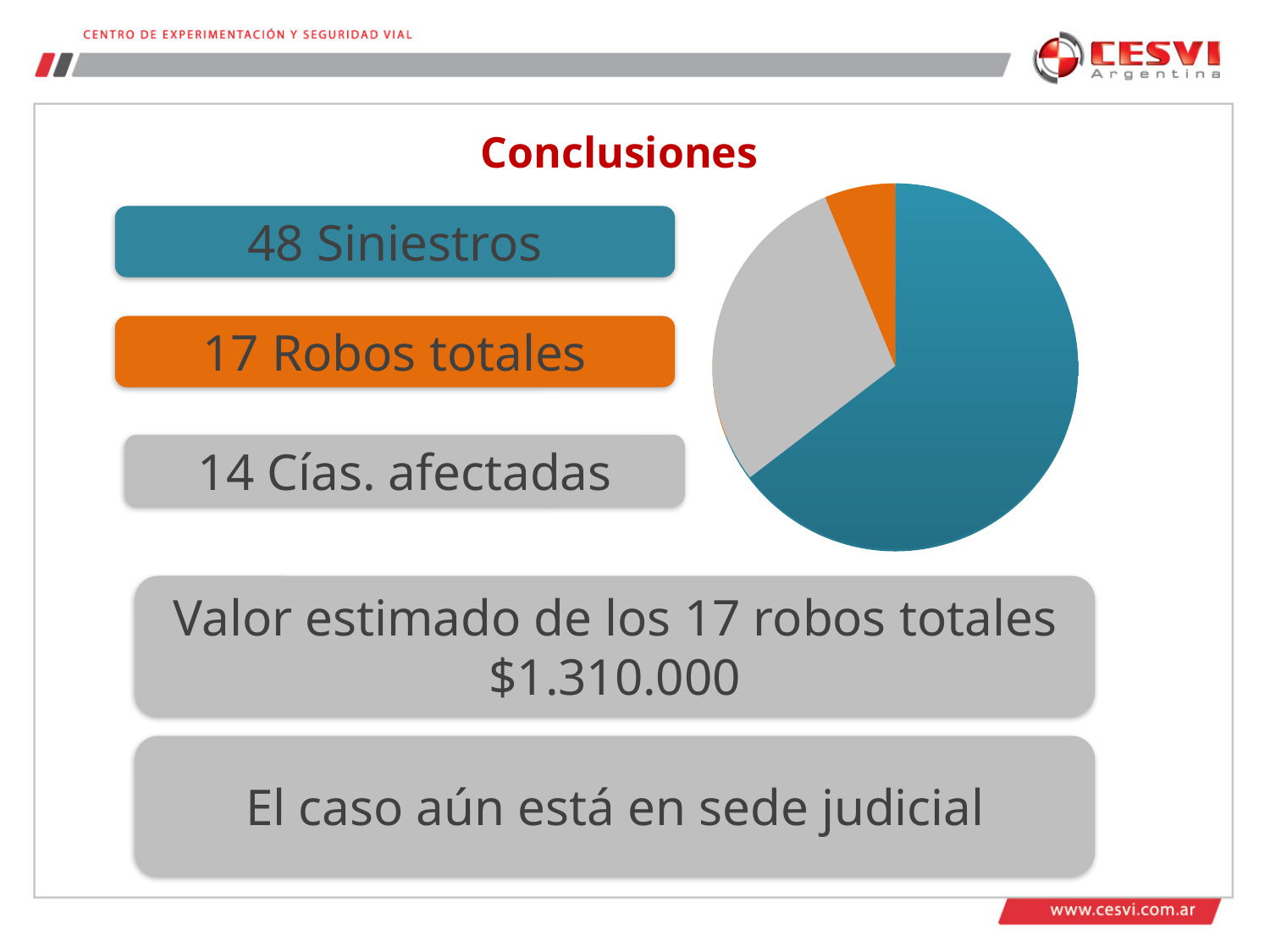
In the pie chart, which is larger, the grey slice or the orange slice? grey Does the blue slice of the pie chart take up more or less than half of the pie? more Which colour slice is the smallest in the pie chart? orange What three colours are used for the slices of the pie chart? blue, grey and orange How many slices does the pie chart have? 3 Which colour slice is the largest in the pie chart? blue Does the orange slice of the pie chart take up more or less than a quarter of the pie? less Does the pie chart display a legend? No In the pie chart, which is larger, the blue slice or the grey slice? blue What kind of chart is shown on the slide? pie chart